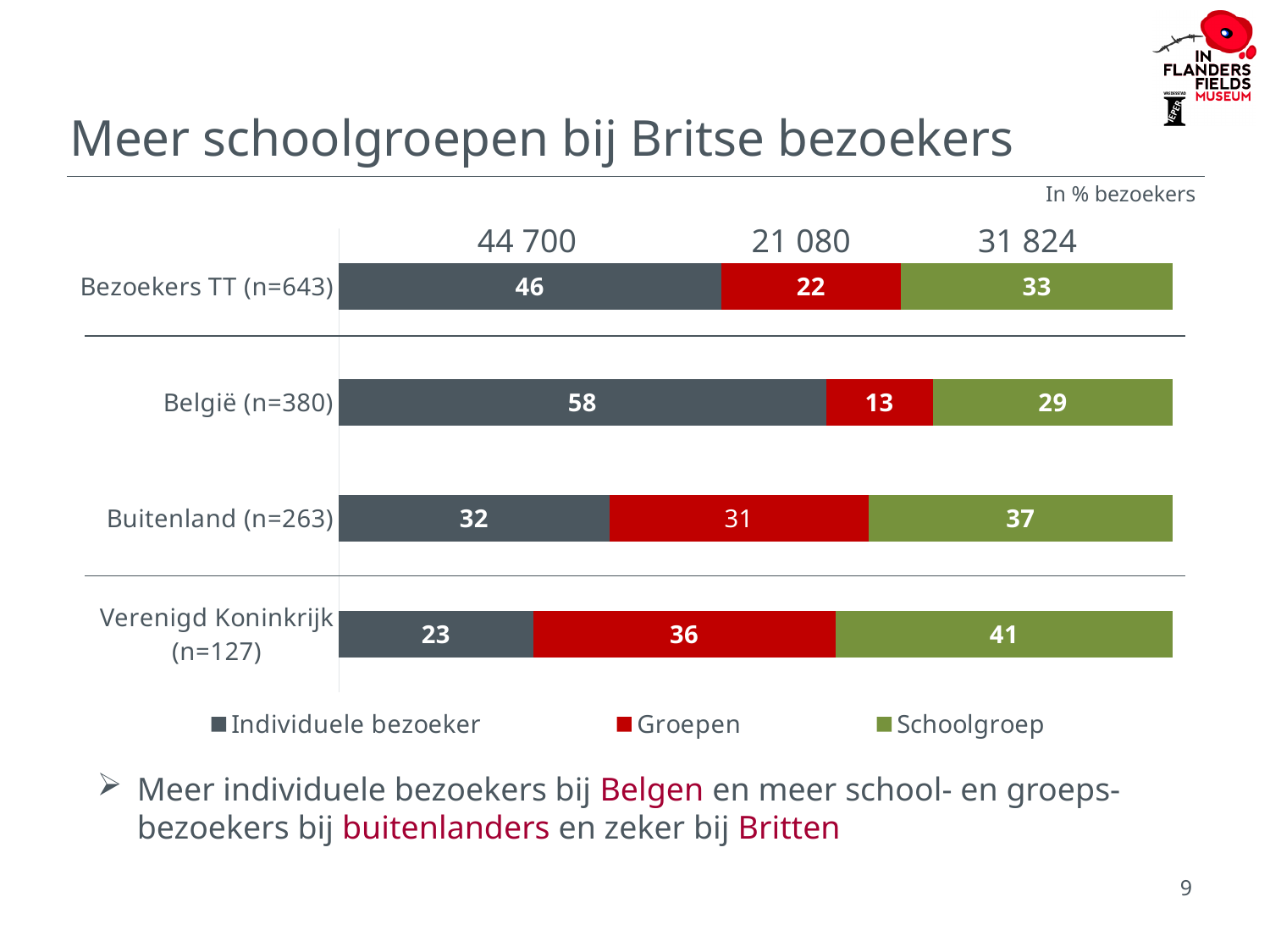
Which is larger: the Groepen value for Verenigd Koninkrijk (n=127) or for Bezoekers TT (n=643)? Verenigd Koninkrijk (n=127) Which series is shown in red in the legend? Groepen Which category has the highest value for Individuele bezoeker? België (n=380) How many series does the legend list? 3 What kind of chart is shown on the slide? Stacked bar chart Which category has the lowest value for Groepen? België (n=380) What is the value for Groepen in the Buitenland (n=263) bar? 31 How many categories are shown on the chart? 4 What is the total of the Buitenland (n=263) stacked bar? 100 What is the value for Individuele bezoeker in the België (n=380) bar? 58 What is the difference between the Schoolgroep values for Verenigd Koninkrijk (n=127) and België (n=380)? 12 What is the value for Schoolgroep in the Verenigd Koninkrijk (n=127) bar? 41